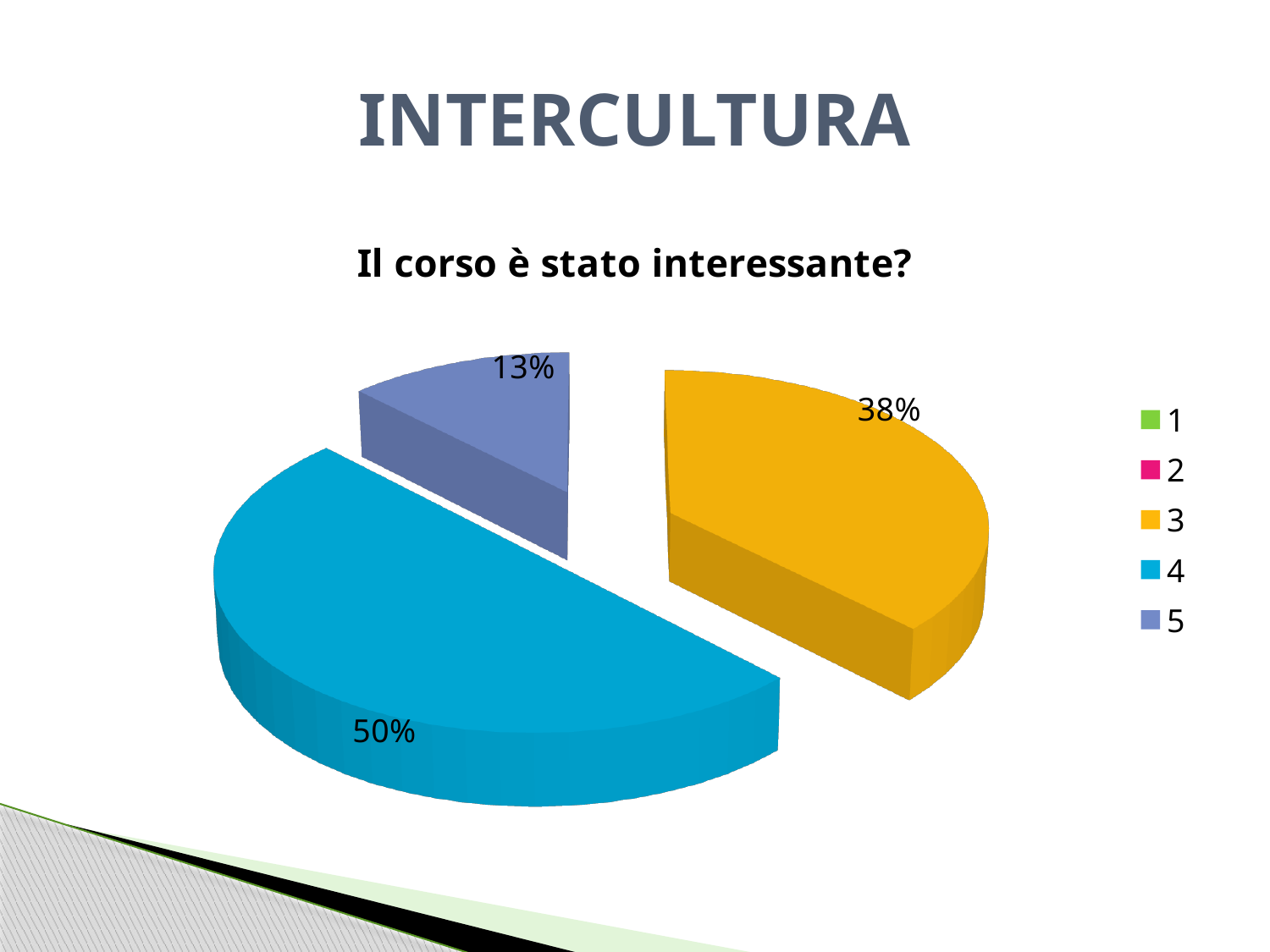
Which category has the largest slice of the pie? 4 What kind of chart is shown on the slide? pie chart What colour is the slice for category 4? blue What share of the pie does category 3 have? 38% What is the title of the chart? Il corso è stato interessante? Which is larger, the share for category 3 or the share for category 5? 3 What share of the pie does category 5 have? 13% Which of the visible slices is the smallest? 5 What is the difference between the shares of category 4 and category 3? 12% How many entries does the legend list? 5 What share of the pie does category 4 have? 50% How many slices are visible in the pie? 3